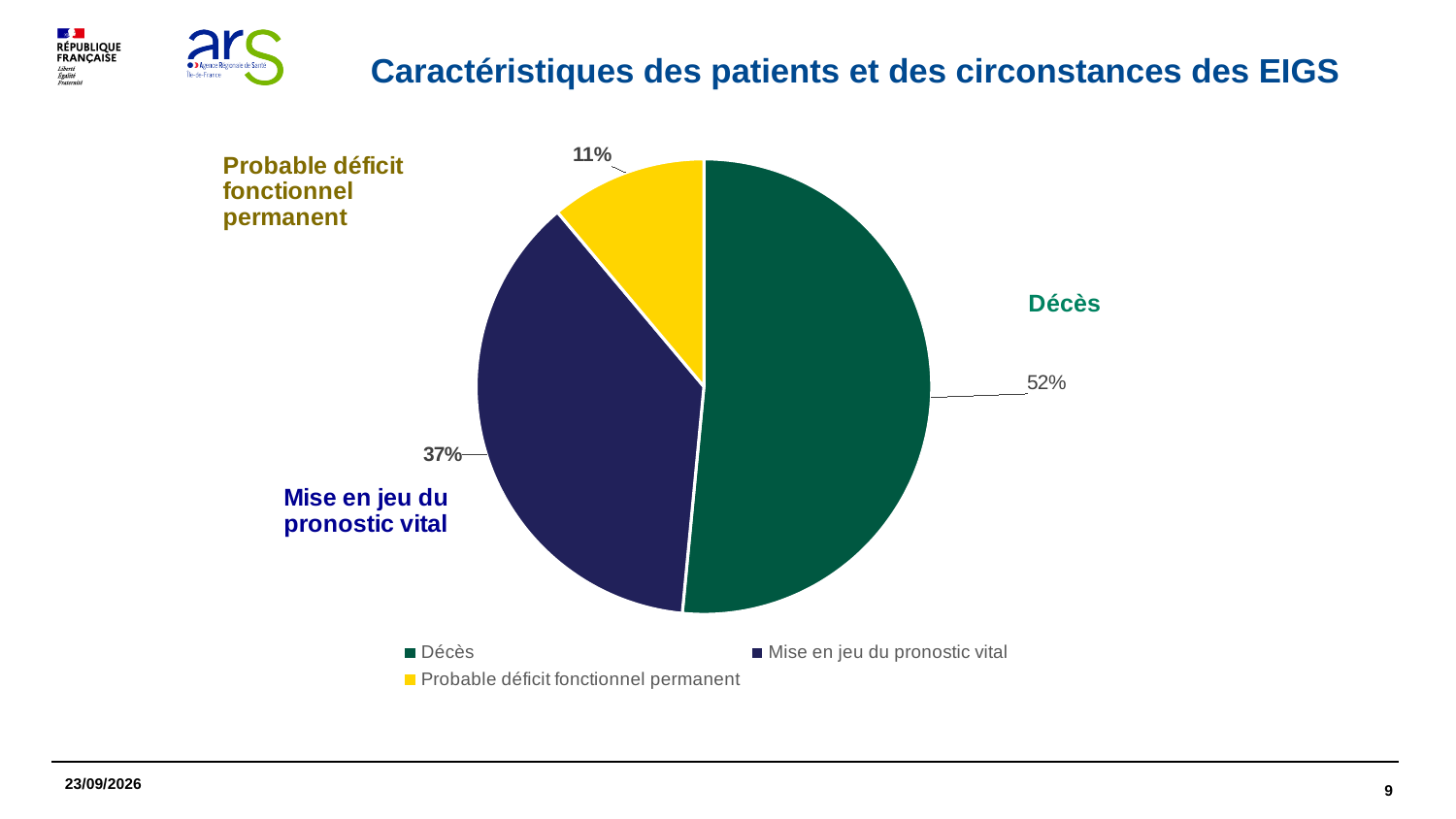
Which is larger, the slice for Décès or the slice for Mise en jeu du pronostic vital? Décès What share of the pie does Probable déficit fonctionnel permanent represent? 11% What is the difference in percentage points between Décès and Mise en jeu du pronostic vital? 15 What is the difference in percentage points between Mise en jeu du pronostic vital and Probable déficit fonctionnel permanent? 26 Which category has the smallest slice of the pie? Probable déficit fonctionnel permanent What colour is the slice for Probable déficit fonctionnel permanent? yellow What share of the pie does Mise en jeu du pronostic vital represent? 37% What share of the pie does Décès represent? 52% What type of chart is shown on the slide? pie chart How many categories does the pie chart show? 3 Which category has the largest slice of the pie? Décès What is the title of the slide containing the pie chart? Caractéristiques des patients et des circonstances des EIGS